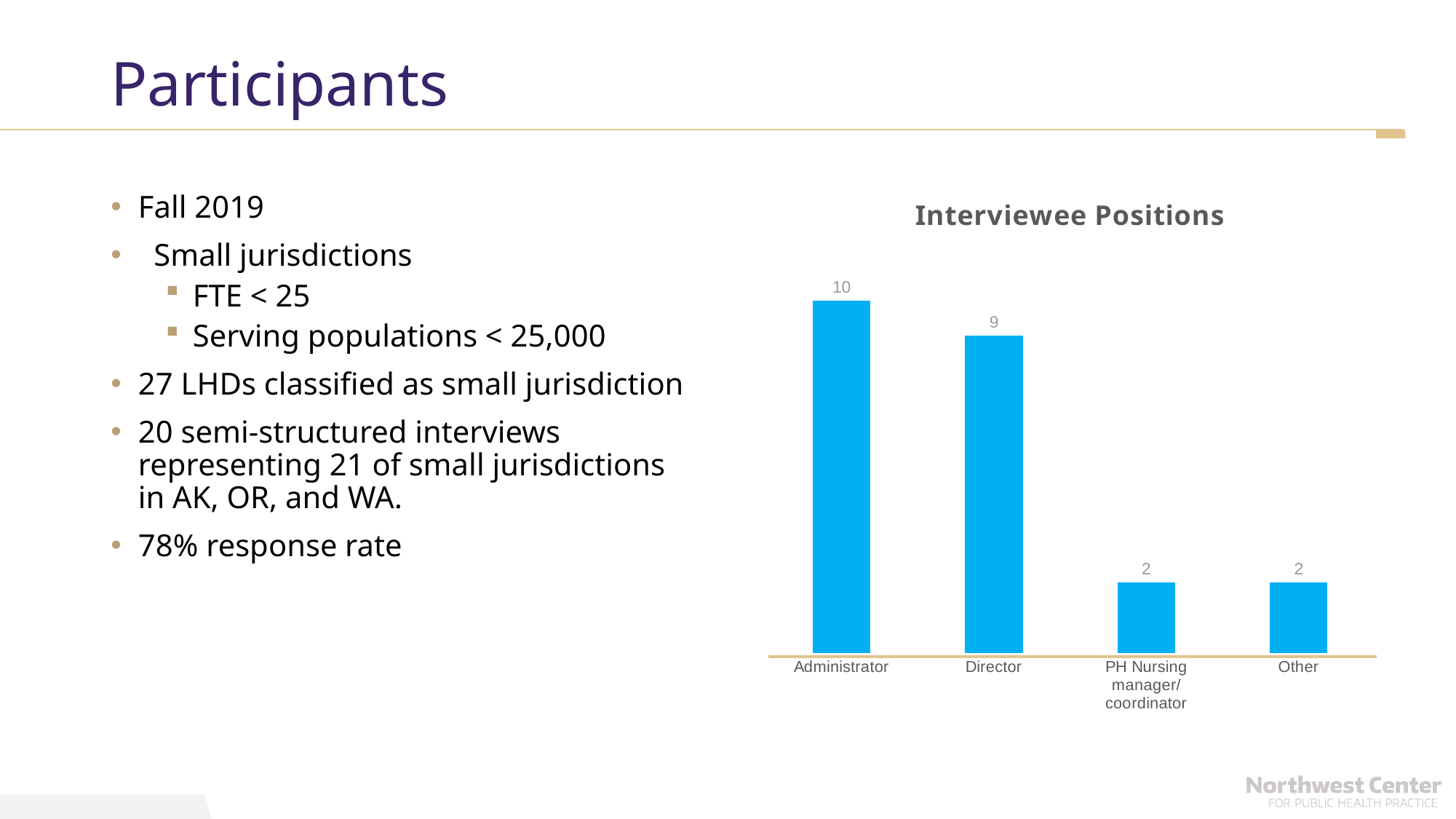
What is the title of the chart on the slide? Interviewee Positions What kind of chart is the Interviewee Positions chart? Bar chart What is the difference between the values for Director and Other? 7 What is the value for PH Nursing manager/coordinator in the Interviewee Positions chart? 2 Which position has the highest value in the Interviewee Positions chart? Administrator What is the value for Other in the Interviewee Positions chart? 2 Which is larger, the value for Administrator or the value for PH Nursing manager/coordinator? Administrator What is the difference between the values for Administrator and Director? 1 What is the total of all values in the Interviewee Positions chart? 23 How many positions are shown in the Interviewee Positions chart? 4 What is the value for Administrator in the Interviewee Positions chart? 10 What is the value for Director in the Interviewee Positions chart? 9